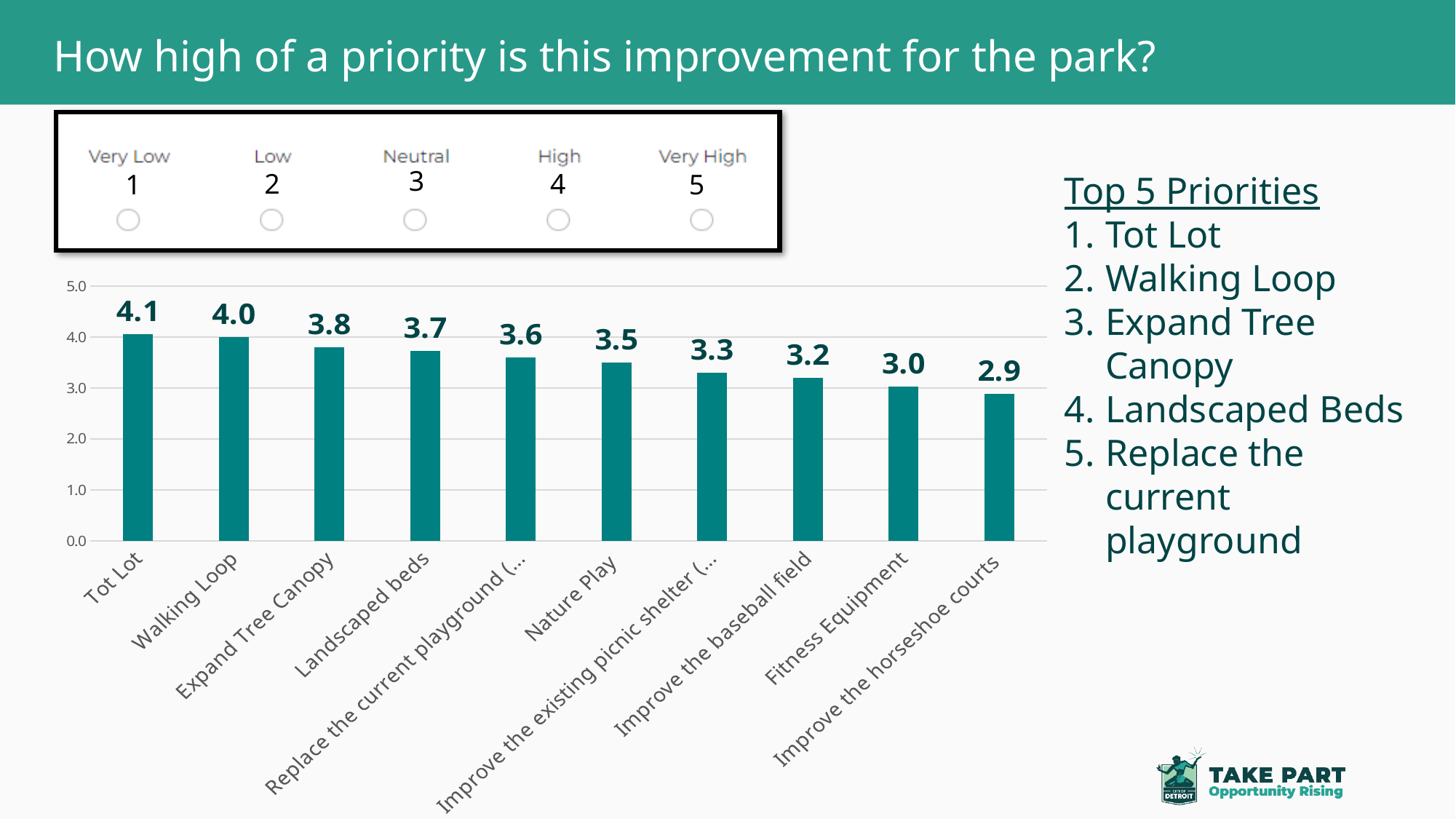
What is the value for Improve the baseball field? 3.2 What is the value for Tot Lot? 4.1 Do the values rise or fall from left to right along the x axis? fall What is the value for Fitness Equipment? 3.0 Which category has the highest value? Tot Lot Which category has the lowest value? Improve the horseshoe courts Is the value for Walking Loop greater or less than 3.0? greater Which is larger, the value for Expand Tree Canopy or the value for Landscaped beds? Expand Tree Canopy What kind of chart is shown on the slide? bar chart What is the difference between the values for Tot Lot and Improve the horseshoe courts? 1.2 How many categories are shown in the chart? 10 What is the value for Nature Play? 3.5